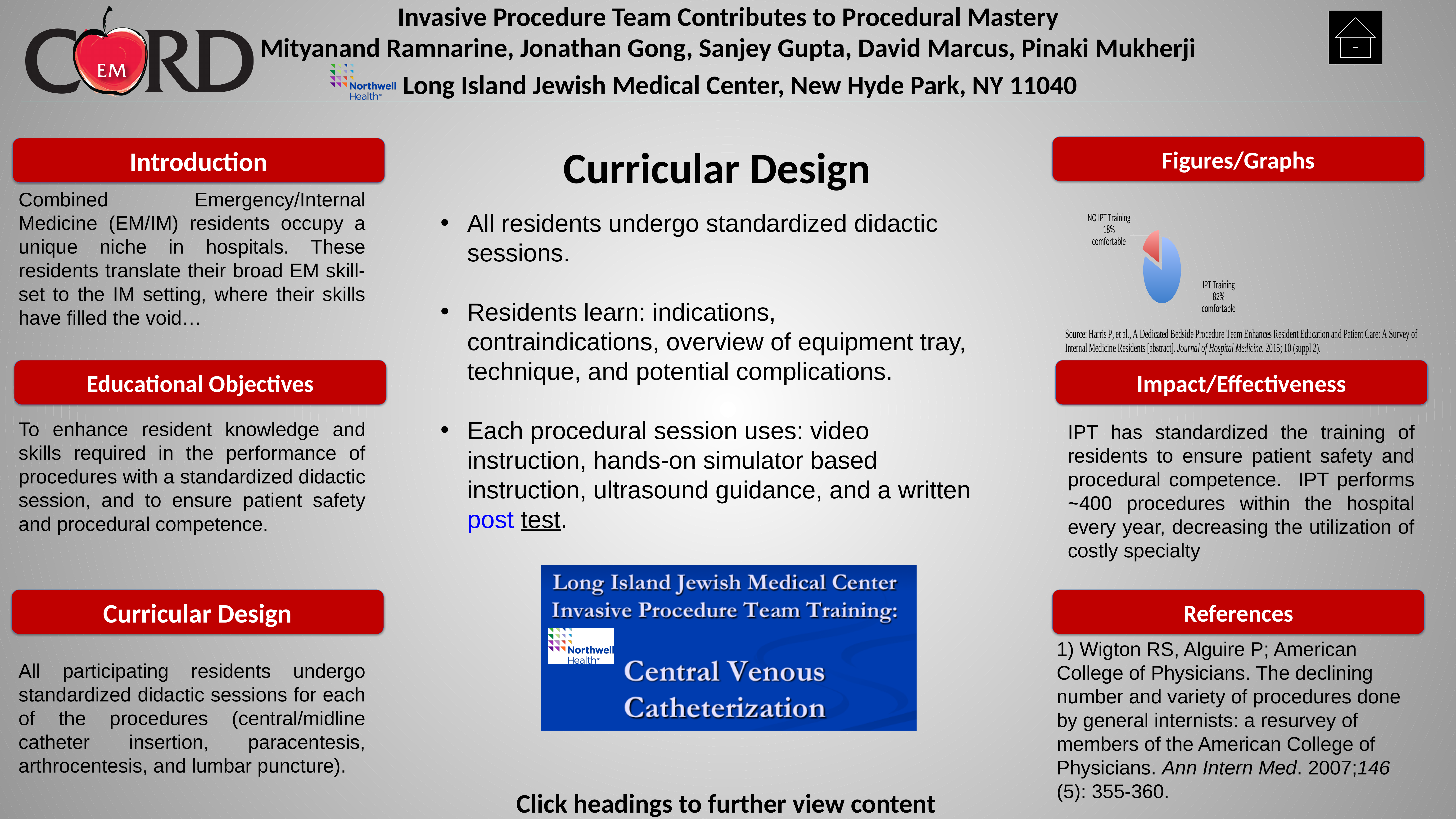
What share of the pie does the IPT Training slice represent? 82% What colour is the NO IPT Training slice in the pie chart? red Which slice of the pie chart is the largest? IPT Training In the pie chart, what percentage is shown for NO IPT Training? 18% What kind of chart is shown in the Figures/Graphs section? pie chart Which slice of the pie chart is the smallest? NO IPT Training What is the difference in percentage points between the IPT Training slice and the NO IPT Training slice? 64 How many slices does the pie chart have? 2 In the pie chart, what percentage is shown for IPT Training? 82% What colour is the IPT Training slice in the pie chart? blue Which is larger in the pie chart: IPT Training or NO IPT Training? IPT Training